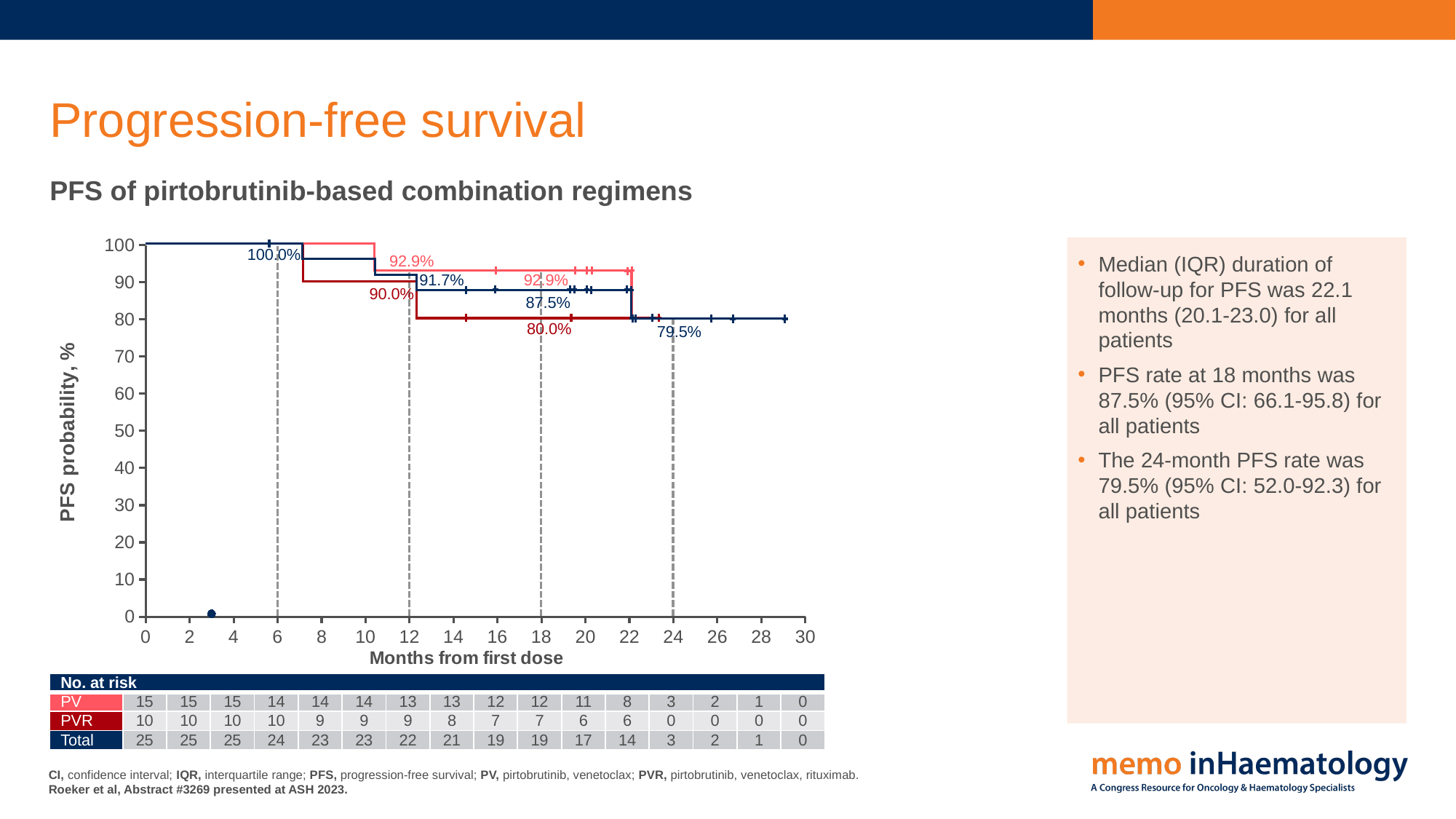
What is the PFS probability for the PV group at 12 months? 92.9% How many patients were at risk in the Total row at 22 months? 14 At 18 months, which group has the higher PFS probability, PV or PVR? PV How many patients were at risk in the PV group at 0 months? 15 What kind of chart is shown on the slide? Line chart (Kaplan-Meier survival curve) What is the PFS probability for all patients (Total) at 18 months? 87.5% What is the PFS probability for all patients (Total) at 24 months? 79.5% What is the label of the x axis? Months from first dose How many groups are listed in the 'No. at risk' table? 3 At 18 months, what is the difference in PFS probability between the PV group (92.9%) and the PVR group (80.0%)? 12.9 percentage points Does the PFS probability rise or fall as months from first dose increase? Fall What is the PFS probability for the PVR group at 12 months? 90.0%